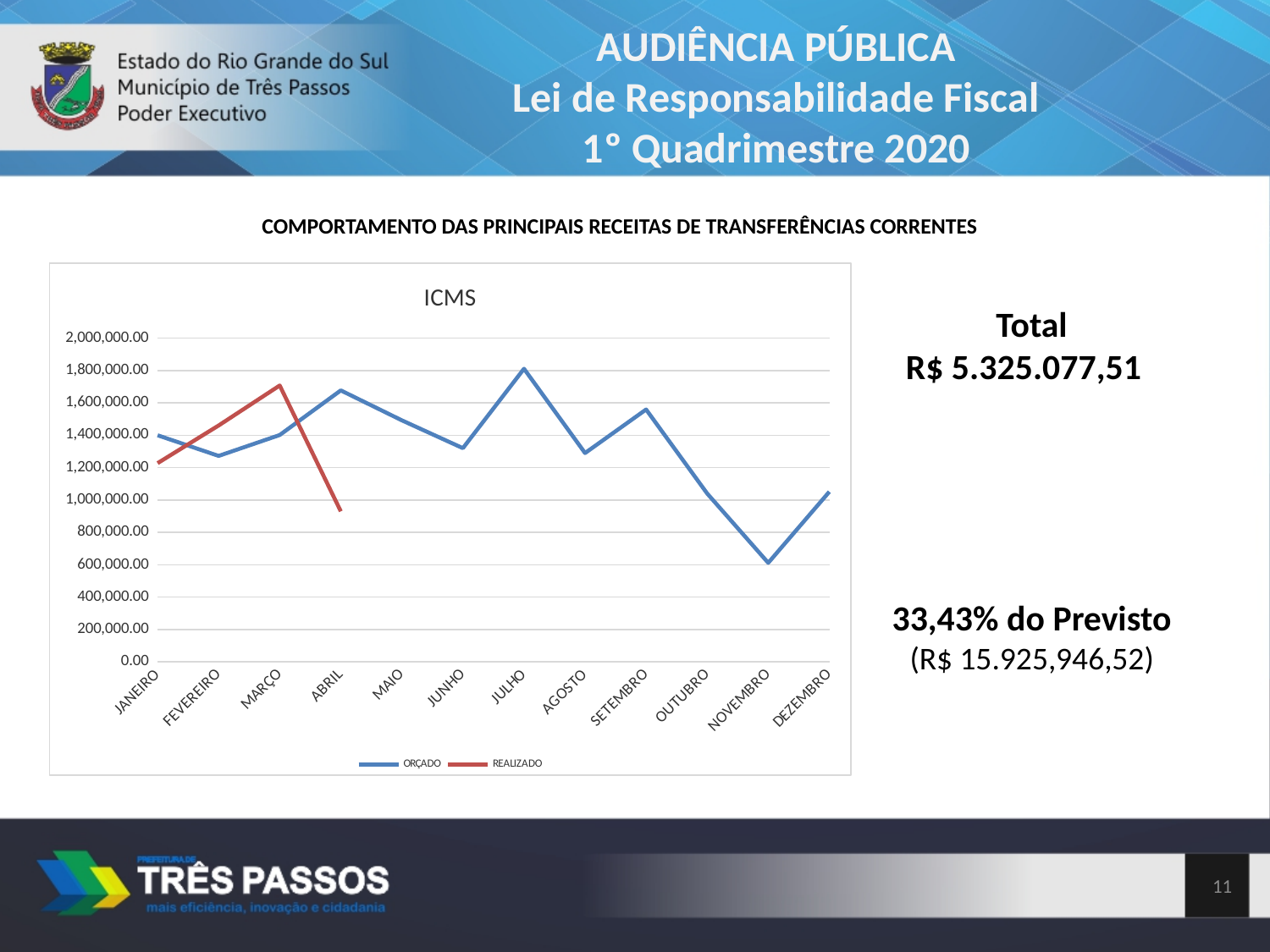
In the ICMS chart, is the ORÇADO value for NOVEMBRO greater or less than 800,000.00? less In the ICMS chart, is the REALIZADO value for ABRIL greater or less than 1,000,000.00? less In the ICMS chart, is the REALIZADO value for MARÇO greater or less than 1,600,000.00? greater What kind of chart is shown on the slide? line chart In the ICMS chart, which month has the lowest ORÇADO value? NOVEMBRO What are the two legend entries of the ICMS chart? ORÇADO and REALIZADO How many series does the legend of the ICMS chart list? 2 In the ICMS chart, which series has the larger value in MARÇO, ORÇADO or REALIZADO? REALIZADO How many months are shown on the x axis of the ICMS chart? 12 In the ICMS chart, which month has the highest ORÇADO value? JULHO In the ICMS chart, which month has the highest REALIZADO value? MARÇO In the ICMS chart, does the REALIZADO line rise or fall from MARÇO to ABRIL? fall